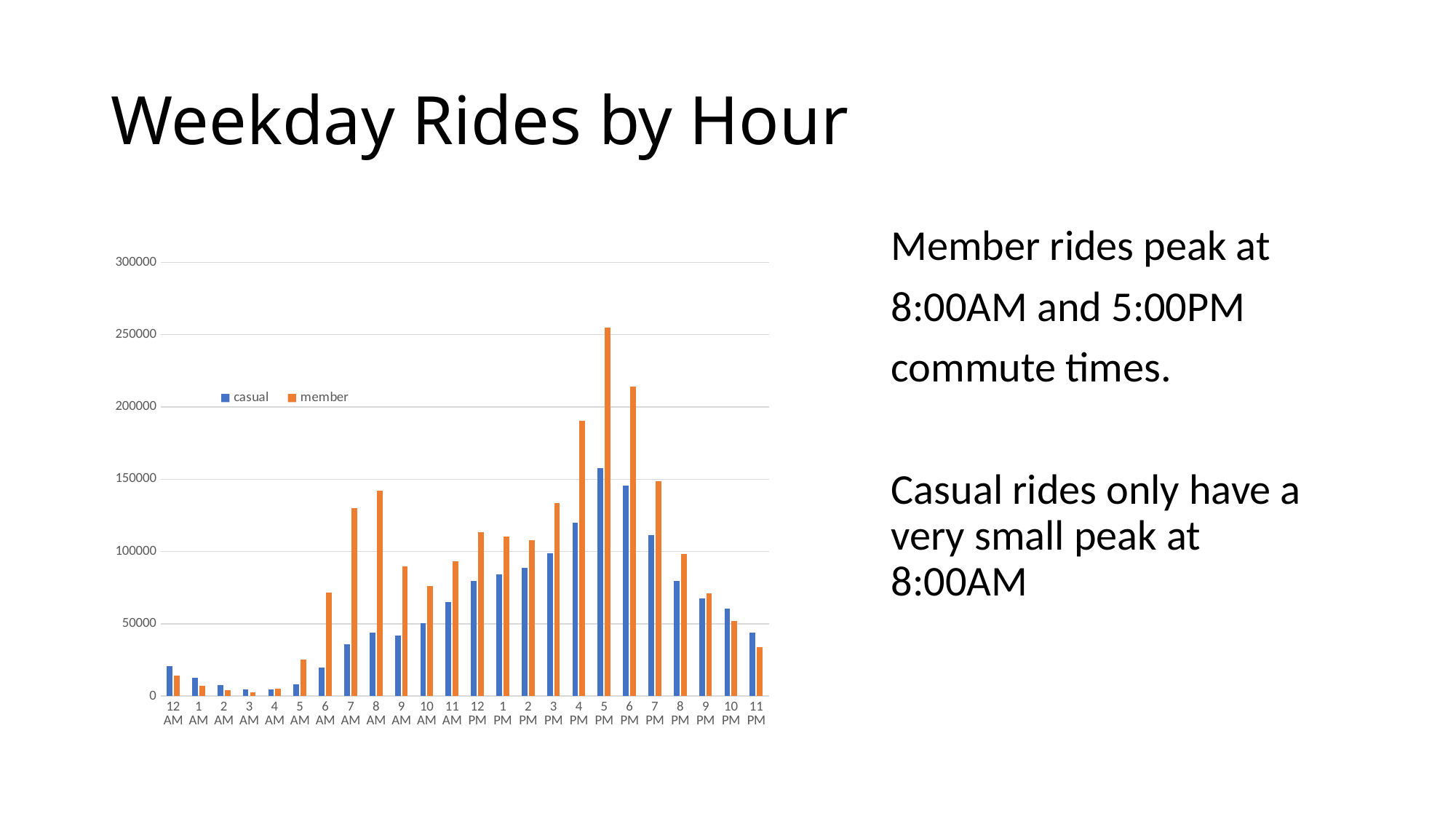
What kind of chart is shown on the slide? bar chart How many series does the legend list? 2 Do member rides rise or fall from 5 AM to 8 AM? rise At which hour is the casual series highest? 5 PM At 12 AM, which series has more rides, casual or member? casual How many hour categories are shown on the x axis? 24 Is the casual value at 12 PM greater or less than 100000? less At which hour is the member series highest? 5 PM Is the member value at 6 PM greater or less than 200000? greater At 8 AM, which series has more rides, casual or member? member Is the member value at 8 AM greater or less than 100000? greater At which hour is the member series lowest? 3 AM